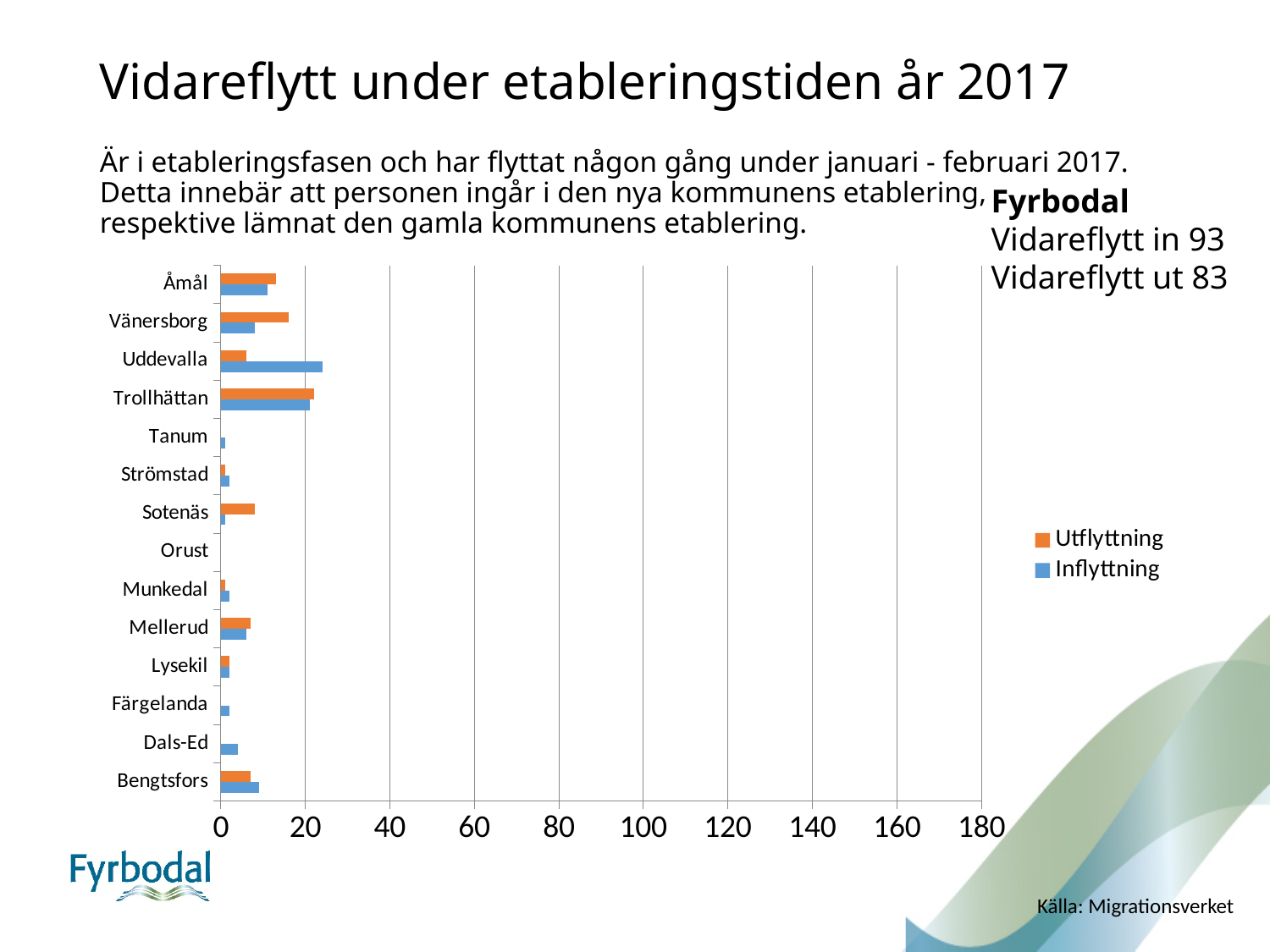
How many municipalities are listed on the vertical axis of the chart? 14 Is the Utflyttning value for Trollhättan greater or less than 20? greater What are the two series named in the chart legend? Utflyttning and Inflyttning What is the highest value shown on the horizontal axis of the chart? 180 For Uddevalla, which is larger: Utflyttning or Inflyttning? Inflyttning For Vänersborg, which is larger: Utflyttning or Inflyttning? Utflyttning What kind of chart is shown on the slide? bar chart Is the Inflyttning value for Uddevalla greater or less than 20? greater How many series does the chart legend list? 2 Is the Utflyttning value for Vänersborg greater or less than 20? less Which municipality has the highest Utflyttning value? Trollhättan Which municipality has the highest Inflyttning value? Uddevalla